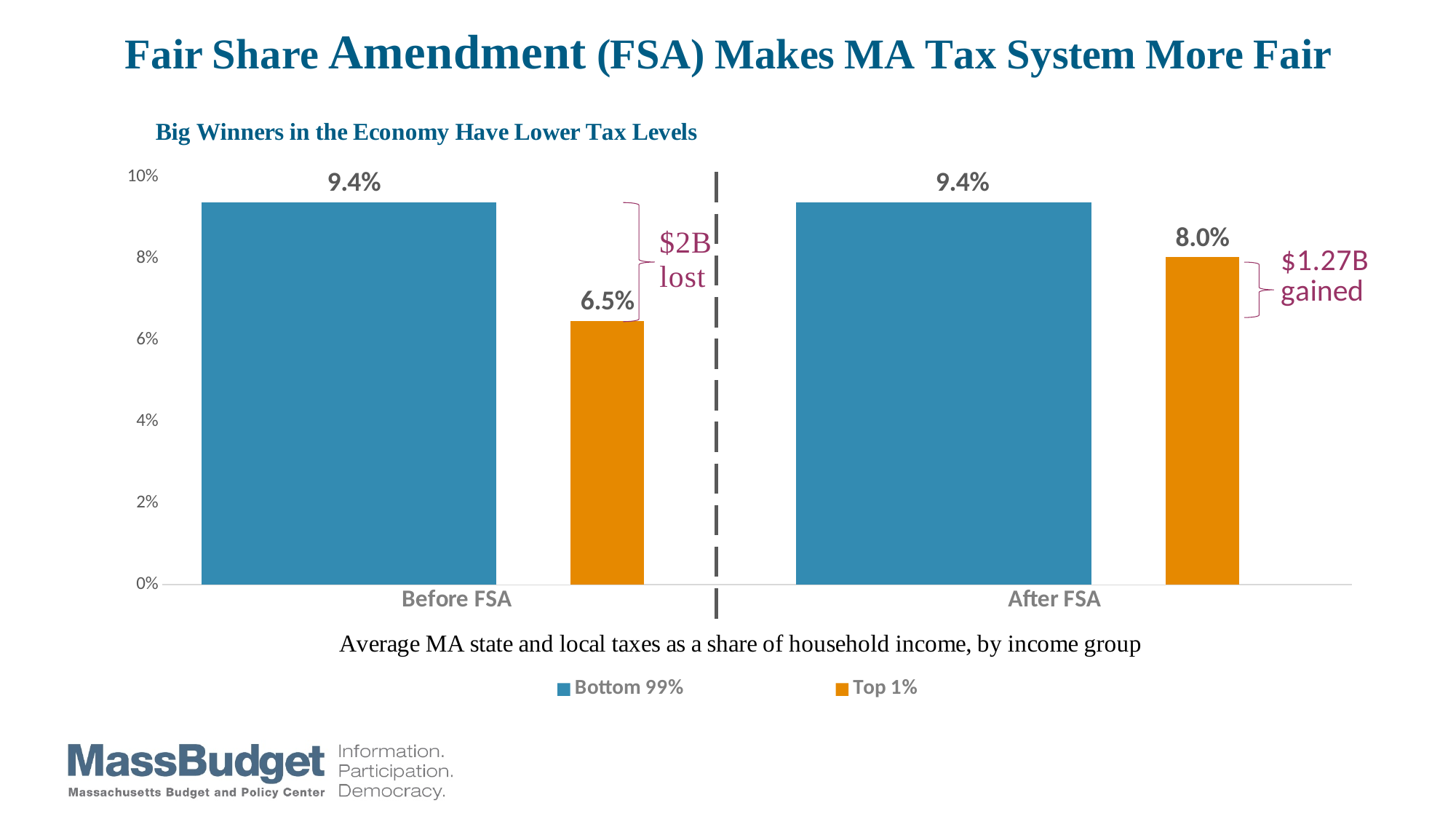
What is the value for Top 1% in the After FSA group? 8.0% Which bar has the lowest value on the chart? Top 1%, Before FSA What is the difference between the Bottom 99% and Top 1% values in the After FSA group? 1.4% How many series does the legend list? 2 Which is larger in the After FSA group, Bottom 99% or Top 1%? Bottom 99% What is the value for Bottom 99% in the Before FSA group? 9.4% What colour represents the Top 1% series? Orange What is the value for Top 1% in the Before FSA group? 6.5% How many category groups are shown on the x axis? 2 What is the difference between the Bottom 99% and Top 1% values in the Before FSA group? 2.9% Is the value for Top 1% in the Before FSA group greater or less than 8%? less What kind of chart is shown on the slide? Bar chart